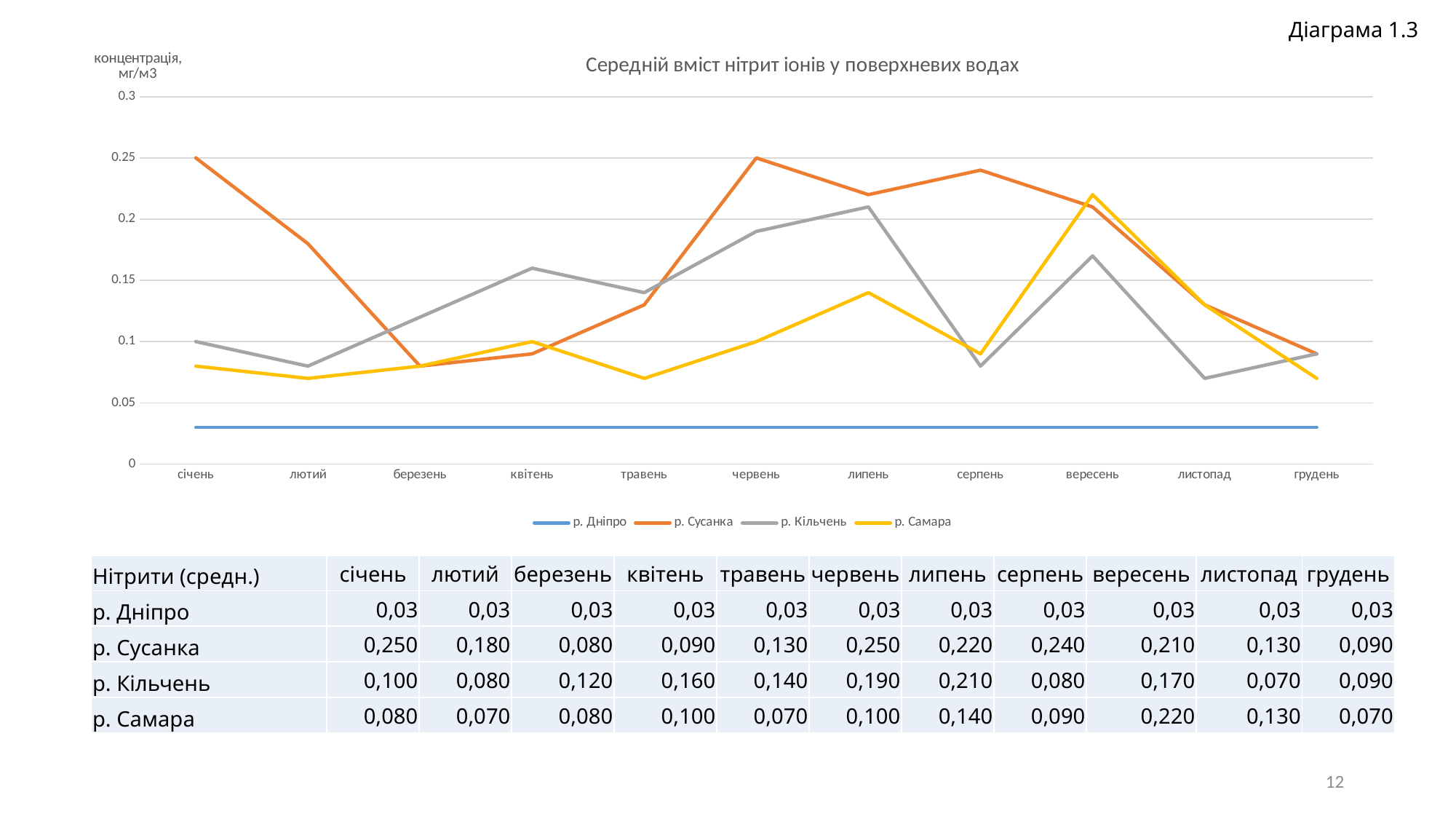
How many series does the chart legend list? 4 In which month does р. Кільчень reach its highest value? липень Is the value for р. Дніпро in травень greater or less than 0.05? less What kind of chart is shown on the slide? line chart What is the difference between р. Сусанка and р. Кільчень in січень? 0,150 What is the value for р. Самара in вересень? 0,220 What is the title of the chart? Середній вміст нітрит іонів у поверхневих водах What is the value for р. Сусанка in червень? 0,250 In which month does р. Кільчень have its lowest value? листопад How many months are plotted along the x axis of the chart? 11 In квітень, which is larger: р. Кільчень or р. Сусанка? р. Кільчень What is the value for р. Кільчень in липень? 0,210